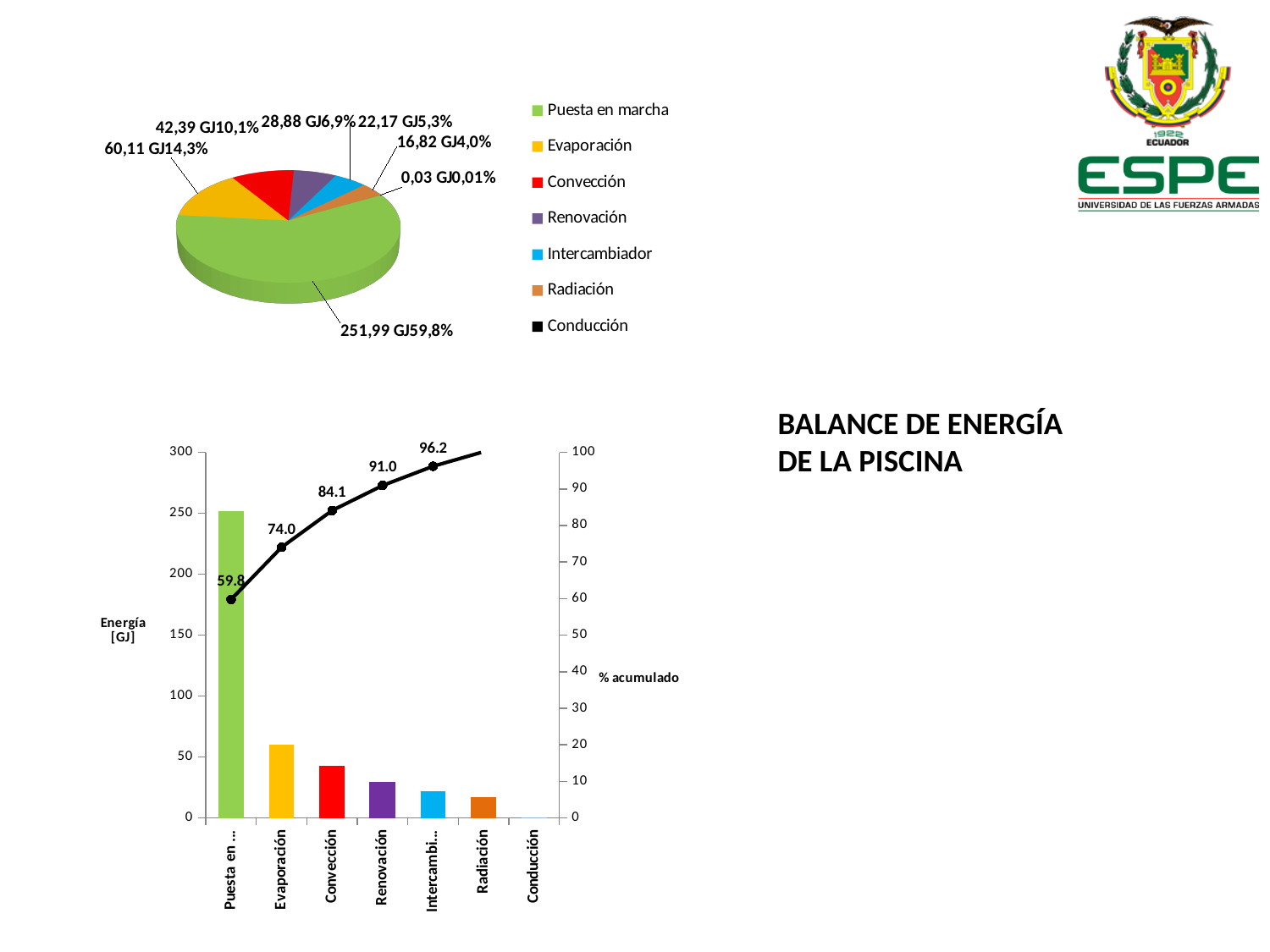
In the pie chart at the top of the slide, what value in GJ is shown for Convección? 42,39 GJ In the bottom chart, what is the cumulative percentage (% acumulado) shown at Intercambiador? 96.2 In the bottom chart, what is the cumulative percentage (% acumulado) shown at Convección? 84.1 In the bottom chart, does the % acumulado line rise or fall from left to right? rise In the pie chart at the top of the slide, what percentage share does Evaporación have? 14,3% In the pie chart at the top of the slide, which is larger, Radiación or Intercambiador? Intercambiador In the pie chart at the top of the slide, what value is shown for Puesta en marcha? 251,99 GJ 59,8% In the pie chart at the top of the slide, what is the difference in GJ between Renovación (28,88 GJ) and Intercambiador (22,17 GJ)? 6,71 GJ In the pie chart at the top of the slide, which category has the largest slice? Puesta en marcha How many entries does the legend of the pie chart at the top of the slide list? 7 In the pie chart at the top of the slide, which category has the smallest slice? Conducción In the bottom chart, is the Energía [GJ] bar for Puesta en marcha greater or less than 200? greater